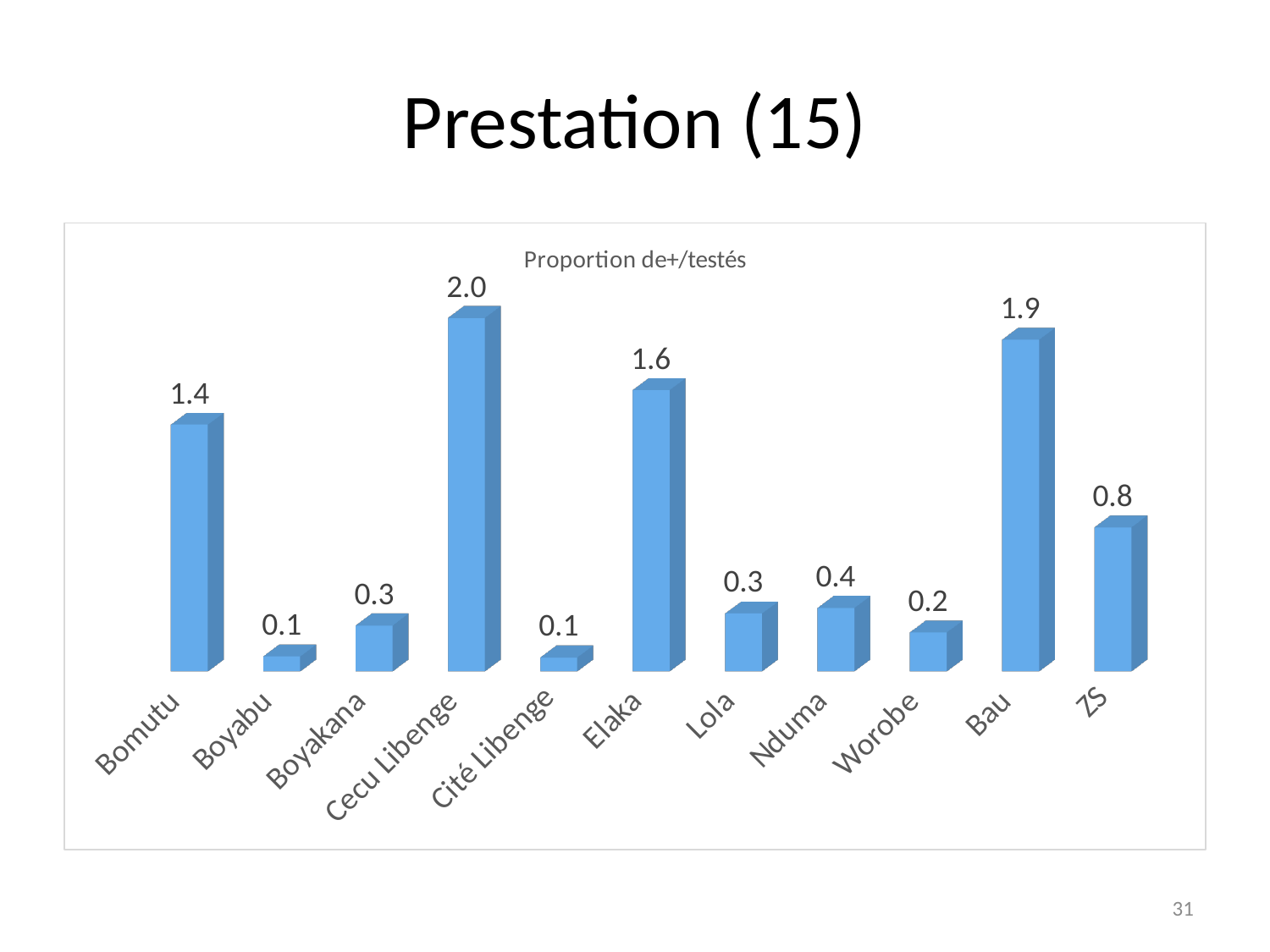
What is the value for Nduma? 0.4 What is the title of the chart? Proportion de+/testés What is the value for Bau? 1.9 What is the value for Cecu Libenge? 2.0 What is the difference between the values for Elaka and Bomutu? 0.2 How many categories are shown on the x axis? 11 What is the difference between the values for Cecu Libenge and ZS? 1.2 Which is larger, the value for Lola or the value for Nduma? Nduma Which category has the highest value? Cecu Libenge Which is larger, the value for Bomutu or the value for Elaka? Elaka What is the value for ZS? 0.8 What kind of chart is shown? bar chart